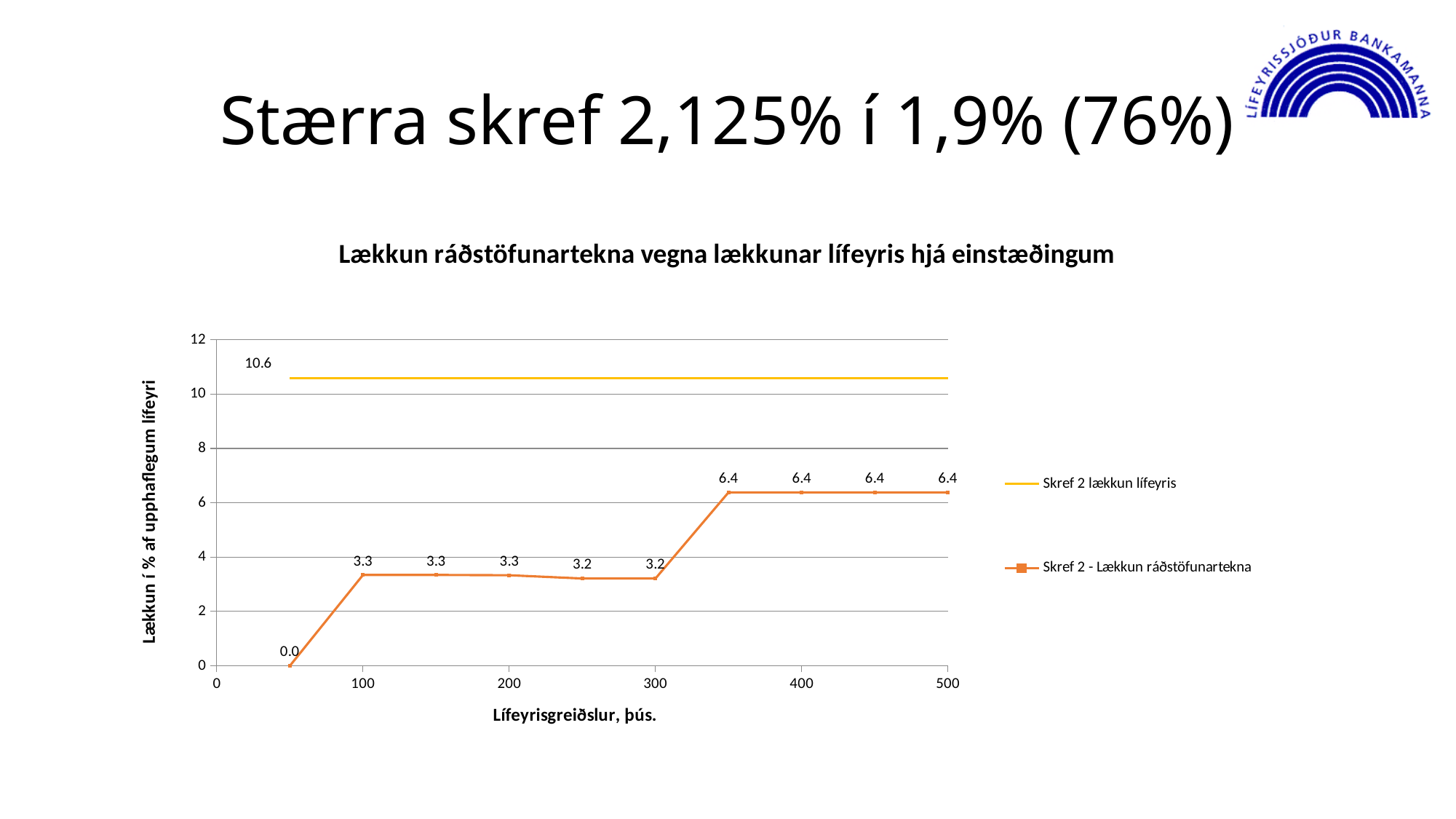
Which series has the larger value at 300 on the x axis, 'Skref 2 lækkun lífeyris' or 'Skref 2 - Lækkun ráðstöfunartekna'? Skref 2 lækkun lífeyris What type of chart is shown on the slide? line chart What is the title of the chart? Lækkun ráðstöfunartekna vegna lækkunar lífeyris hjá einstæðingum What is the value of the 'Skref 2 lækkun lífeyris' line? 10.6 What is the value of 'Skref 2 - Lækkun ráðstöfunartekna' at 500 on the x axis? 6.4 What is the value of 'Skref 2 - Lækkun ráðstöfunartekna' at 100 on the x axis? 3.3 What is the value of 'Skref 2 - Lækkun ráðstöfunartekna' at 250 on the x axis? 3.2 What is the lowest value of the 'Skref 2 - Lækkun ráðstöfunartekna' series? 0.0 What is the highest value of the 'Skref 2 - Lækkun ráðstöfunartekna' series? 6.4 How many data points are labelled on the 'Skref 2 - Lækkun ráðstöfunartekna' series? 10 What is the difference between the 'Skref 2 lækkun lífeyris' value (10.6) and the 'Skref 2 - Lækkun ráðstöfunartekna' value at 400 (6.4)? 4.2 How many series does the legend list? 2